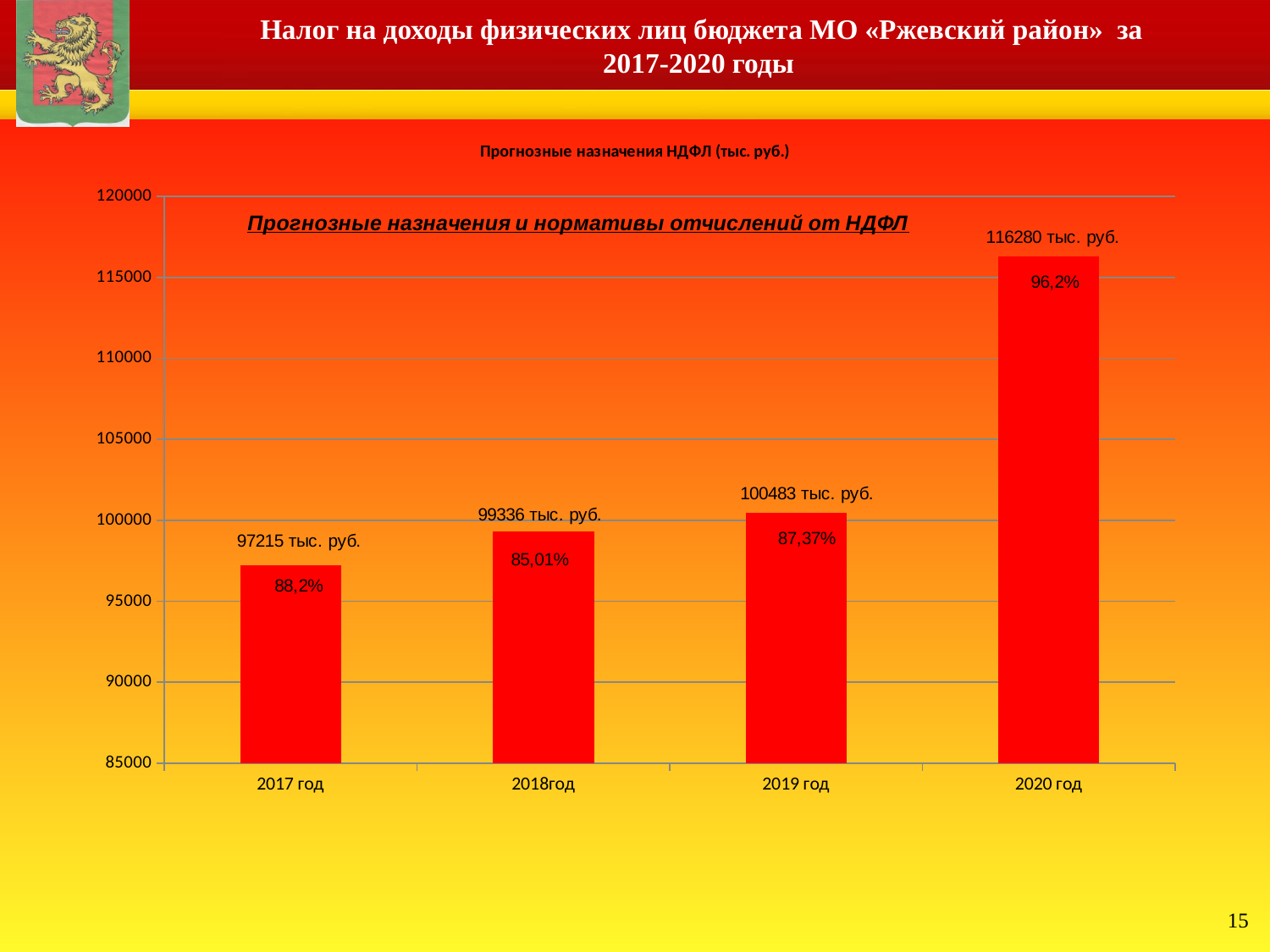
How many years (bars) are shown in the chart? 4 What kind of chart is shown on the slide? bar chart Which year has the lowest forecast NDFL value? 2017 год What is the forecast NDFL value shown for 2020 год? 116280 тыс. руб. What is the forecast NDFL value shown for 2017 год? 97215 тыс. руб. Is the value for 2019 год greater or less than 100000? greater What percentage is printed on the bar for 2019 год? 87,37% Do the forecast NDFL values rise or fall from 2017 год to 2020 год? rise What is the difference between the forecast NDFL values for 2020 год and 2019 год, in тыс. руб.? 15797 What percentage is printed on the bar for 2018год? 85,01% Which is larger, the forecast NDFL value for 2018год or for 2019 год? 2019 год Which year has the highest forecast NDFL value? 2020 год